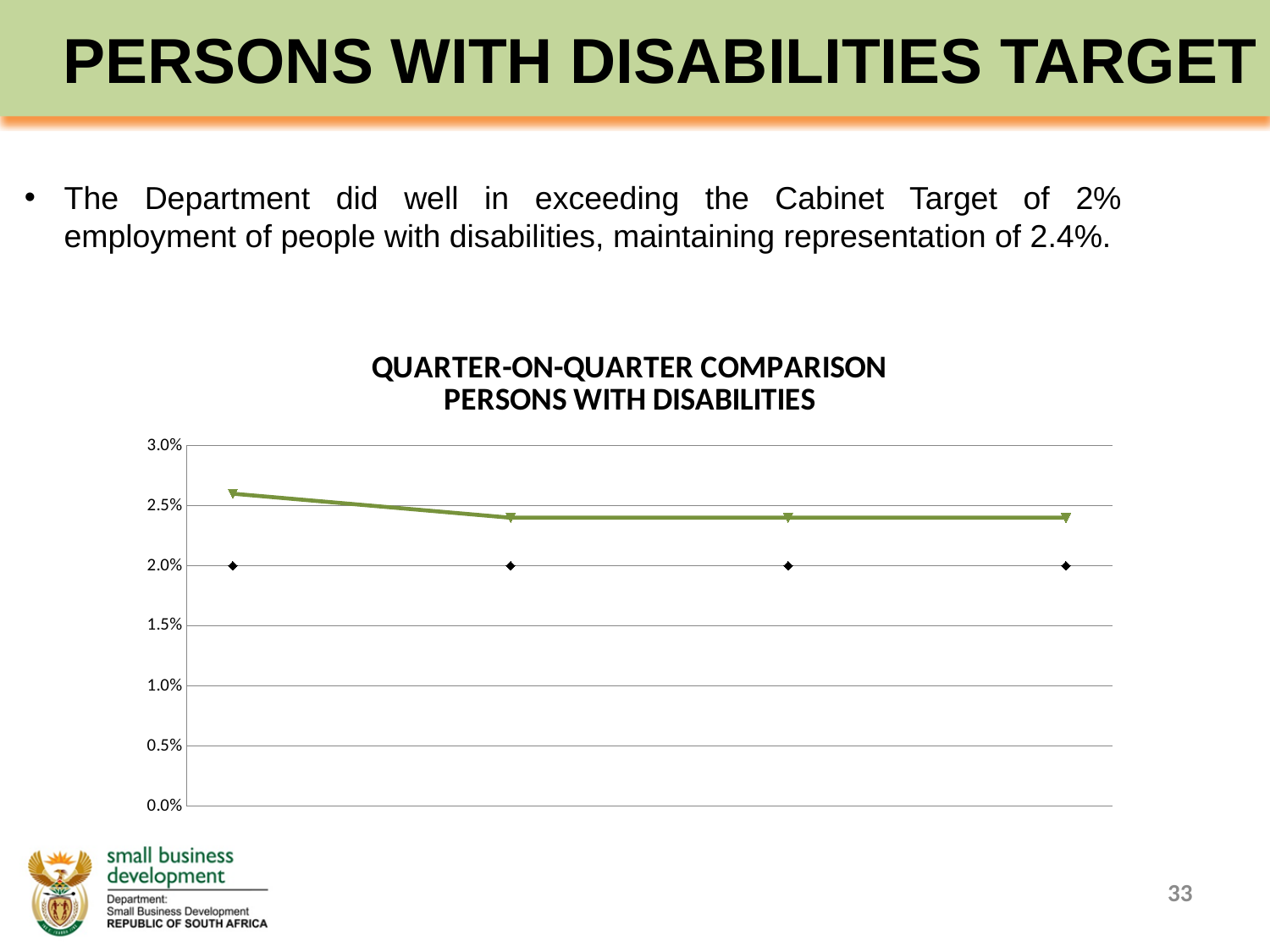
What is the title of the chart? QUARTER-ON-QUARTER COMPARISON PERSONS WITH DISABILITIES Which point of the green line is the highest? the first point Is the last point of the green line greater or less than 2.5%? less Does the green line rise or fall from the first point to the second point? fall What kind of chart is shown on the slide? line chart How many data points does each line in the chart have? 4 Is the last point of the green line greater or less than 2.0%? greater What value does the black diamond-marker line sit at across all points? 2.0% Which line is higher at the first point, the green line or the black line? the green line Is the first point of the green line greater or less than 2.5%? greater What is the highest value shown on the vertical axis? 3.0%